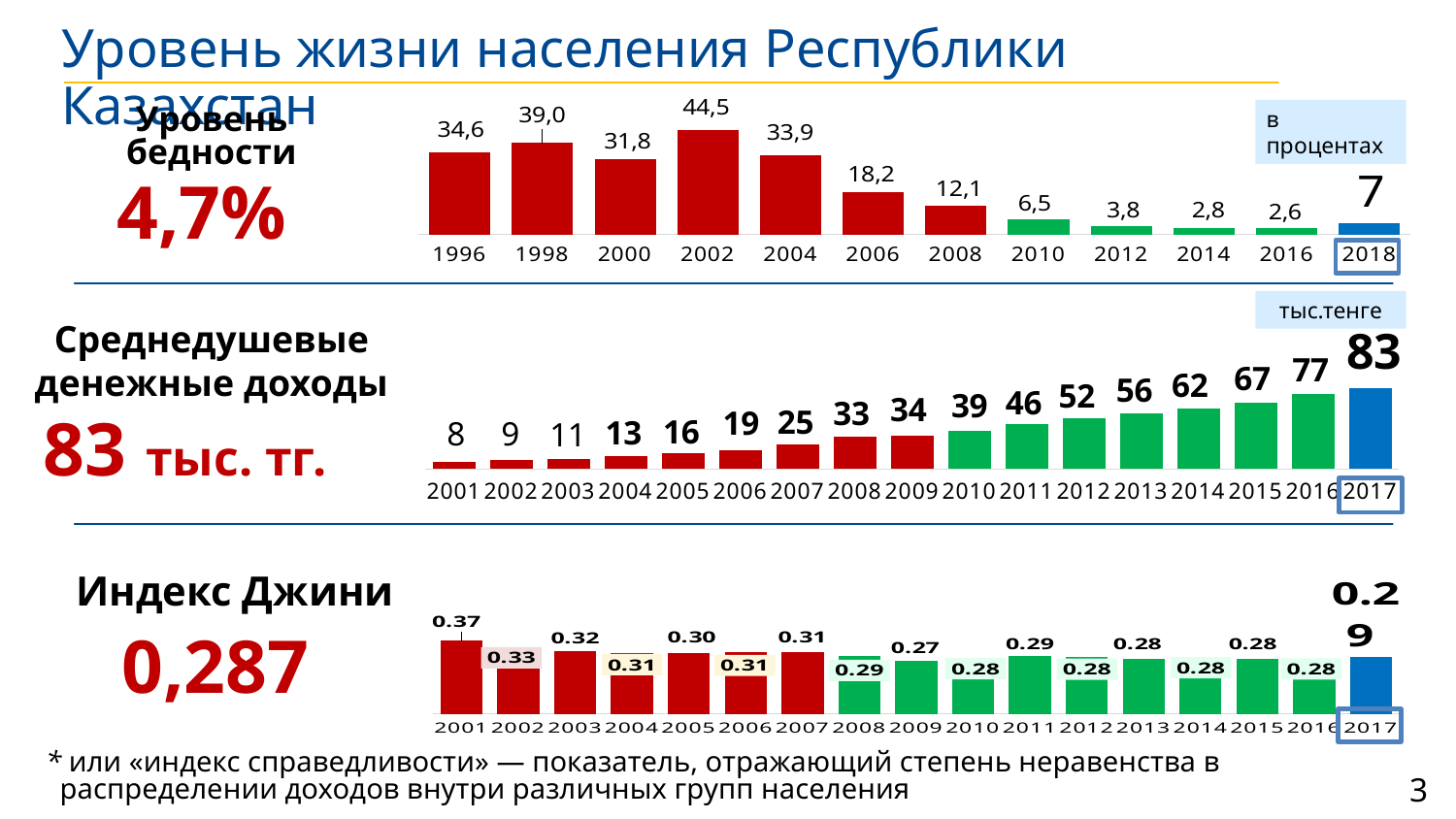
In the per capita income chart (Среднедушевые денежные доходы), do the values rise or fall from 2001 to 2017? rise In the Gini index chart (Индекс Джини), what is the value for 2001? 0.37 In the poverty level chart (Уровень бедности), which year has the highest value? 2002 In the per capita income chart (Среднедушевые денежные доходы), what is the difference between the values for 2017 and 2016? 6 In the Gini index chart (Индекс Джини), which year has the lowest value? 2009 In the per capita income chart (Среднедушевые денежные доходы), what is the value for 2013? 56 In the per capita income chart (Среднедушевые денежные доходы), how many years are plotted? 17 In the poverty level chart (Уровень бедности), what is the value for 2002? 44,5 In the poverty level chart (Уровень бедности), what is the difference between the values for 1998 and 2000? 7,2 What type of chart is the Gini index chart (Индекс Джини)? bar chart In the poverty level chart (Уровень бедности), which is larger, the value for 2006 or for 2008? 2006 In the poverty level chart (Уровень бедности), what is the value for 2010? 6,5